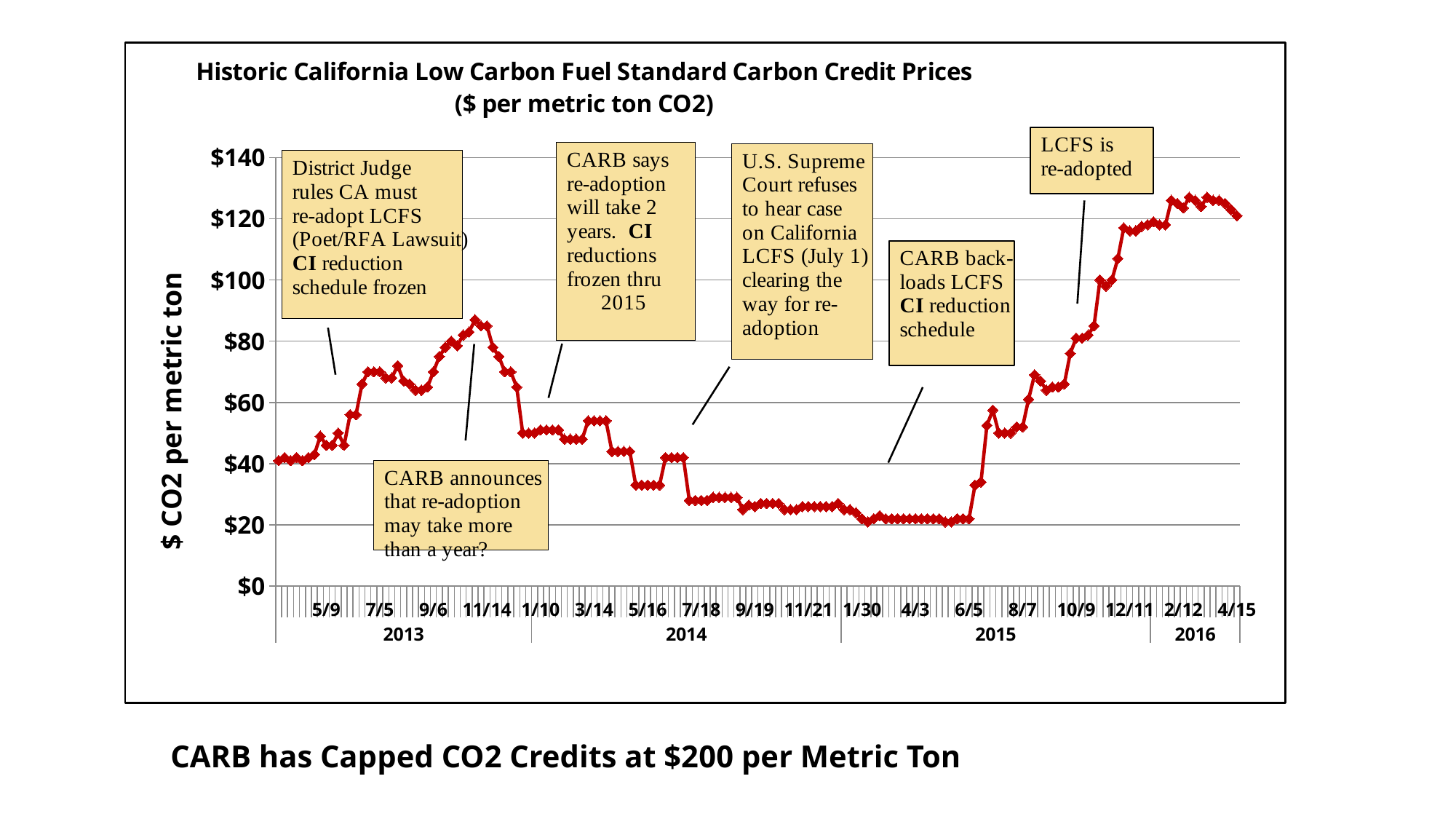
Is the value at 11/14 in 2013 greater or less than $80? greater Do the credit prices rise or fall between 6/5 2015 and 2/12 2016? rise Is the value at 1/30 in 2015 greater or less than $40? less Is the value at 7/5 in 2013 greater or less than $60? greater What kind of chart is shown on the slide? line chart What is the label on the vertical axis of the chart? $ CO2 per metric ton Do the credit prices rise or fall between 11/14 2013 and 1/30 2015? fall What is the title of the chart? Historic California Low Carbon Fuel Standard Carbon Credit Prices ($ per metric ton CO2) Which is higher: the price at 4/15 2016 or the price at 1/30 2015? 4/15 2016